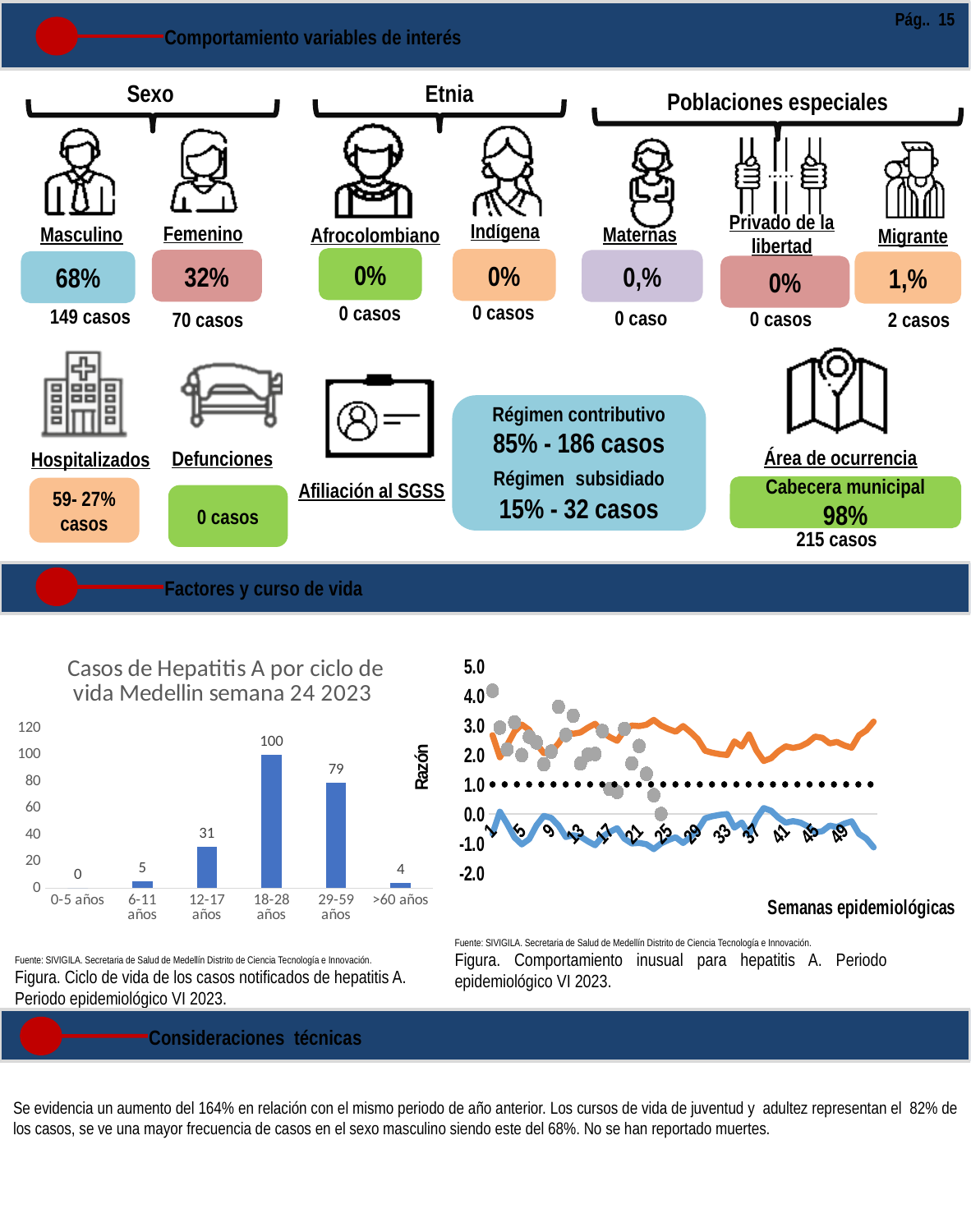
What kind of chart is 'Casos de Hepatitis A por ciclo de vida Medellin semana 24 2023'? Bar chart In the chart 'Casos de Hepatitis A por ciclo de vida Medellin semana 24 2023', which is larger, the value for 12-17 años or the value for >60 años? 12-17 años In the chart 'Casos de Hepatitis A por ciclo de vida Medellin semana 24 2023', what is the difference between the values for 18-28 años and 29-59 años? 21 In the chart 'Casos de Hepatitis A por ciclo de vida Medellin semana 24 2023', which age group has the highest value? 18-28 años In the chart 'Casos de Hepatitis A por ciclo de vida Medellin semana 24 2023', what is the total of the values for 6-11 años and 12-17 años? 36 In the chart 'Casos de Hepatitis A por ciclo de vida Medellin semana 24 2023', which age group has the lowest value? 0-5 años In the chart 'Casos de Hepatitis A por ciclo de vida Medellin semana 24 2023', what is the value for 12-17 años? 31 In the chart 'Casos de Hepatitis A por ciclo de vida Medellin semana 24 2023', what is the value for 6-11 años? 5 In the chart 'Casos de Hepatitis A por ciclo de vida Medellin semana 24 2023', how many age groups are shown on the x axis? 6 In the chart on the right of the slide (with the x axis 'Semanas epidemiológicas'), what is the label of the vertical axis? Razón In the chart 'Casos de Hepatitis A por ciclo de vida Medellin semana 24 2023', what is the value for 18-28 años? 100 In the chart 'Casos de Hepatitis A por ciclo de vida Medellin semana 24 2023', what is the value for 29-59 años? 79